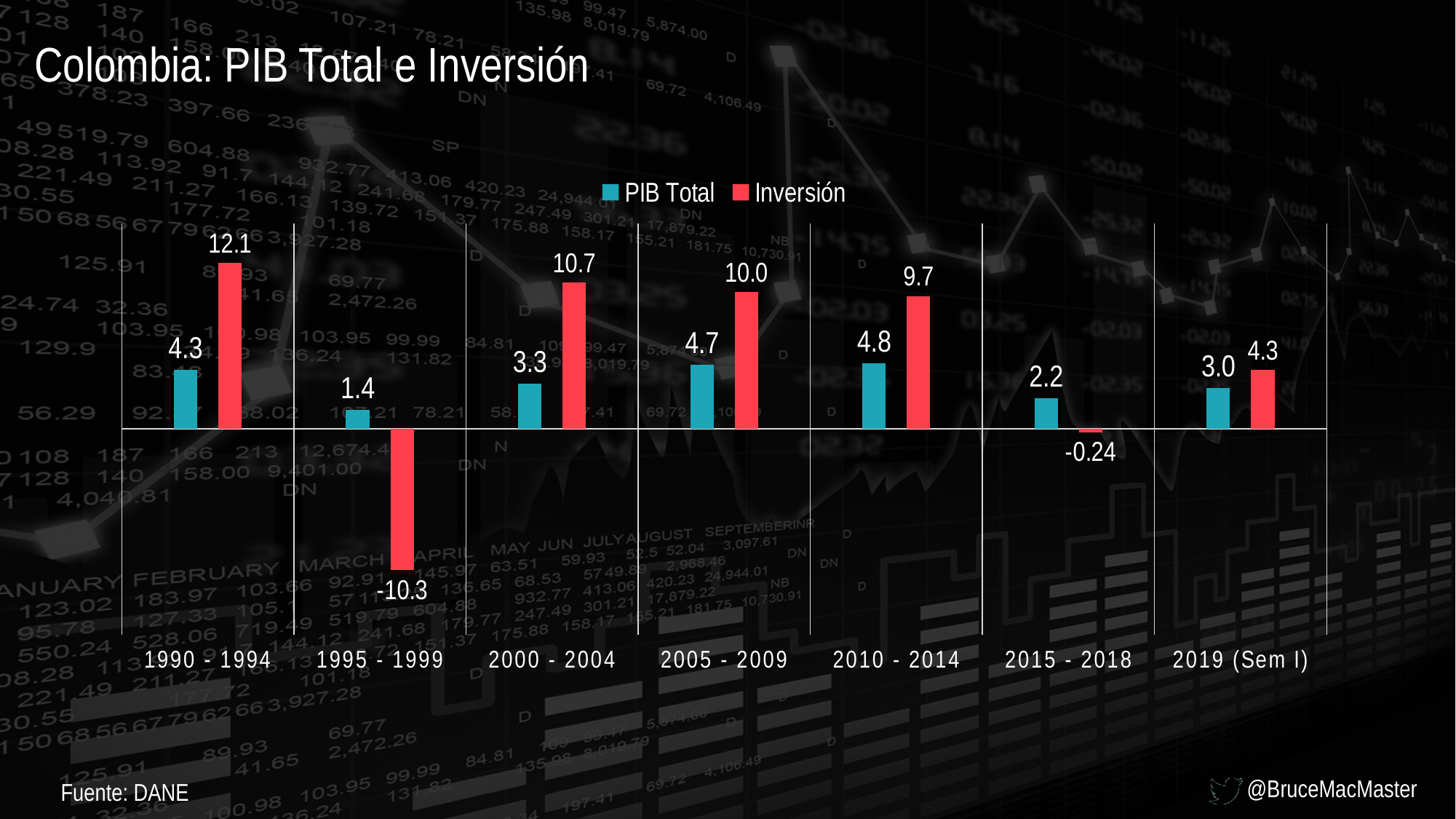
How many periods are shown on the x axis? 7 What is the title of the chart? Colombia: PIB Total e Inversión What is the Inversión value for 1995 - 1999? -10.3 Which period has the lowest PIB Total value? 1995 - 1999 How many series does the legend list? 2 What is the difference between Inversión and PIB Total in 2005 - 2009? 5.3 Which is larger in 2000 - 2004, PIB Total or Inversión? Inversión What is the Inversión value for 2015 - 2018? -0.24 What kind of chart is shown on the slide? Bar chart What is the PIB Total value for 1990 - 1994? 4.3 What is the PIB Total value for 2019 (Sem I)? 3.0 Which period has the highest Inversión value? 1990 - 1994